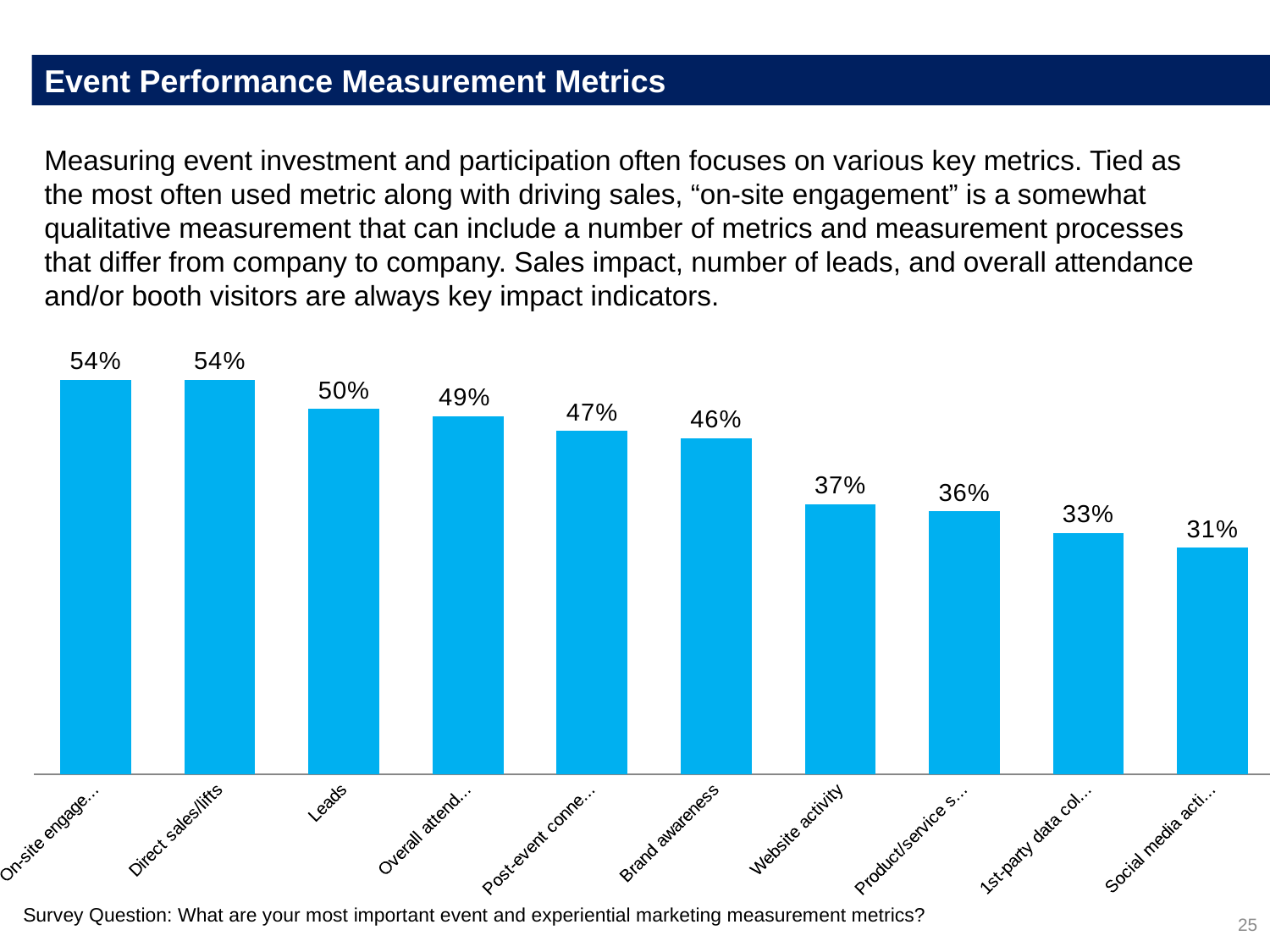
Do the values rise or fall from left to right across the chart? Fall What is the lowest value shown in the chart? 31% What is the difference between the values for Leads and Website activity? 13 percentage points What is the highest value shown in the chart? 54% How many bars are shown in the chart? 10 What is the value shown for Direct sales/lifts? 54% What kind of chart is shown on the slide? Bar chart What is the value shown for Brand awareness? 46% What is the value shown for Leads? 50% What is the value shown for Website activity? 37% What is the value of the leftmost bar in the chart? 54% Which is larger, the value for Brand awareness or the value for Website activity? Brand awareness